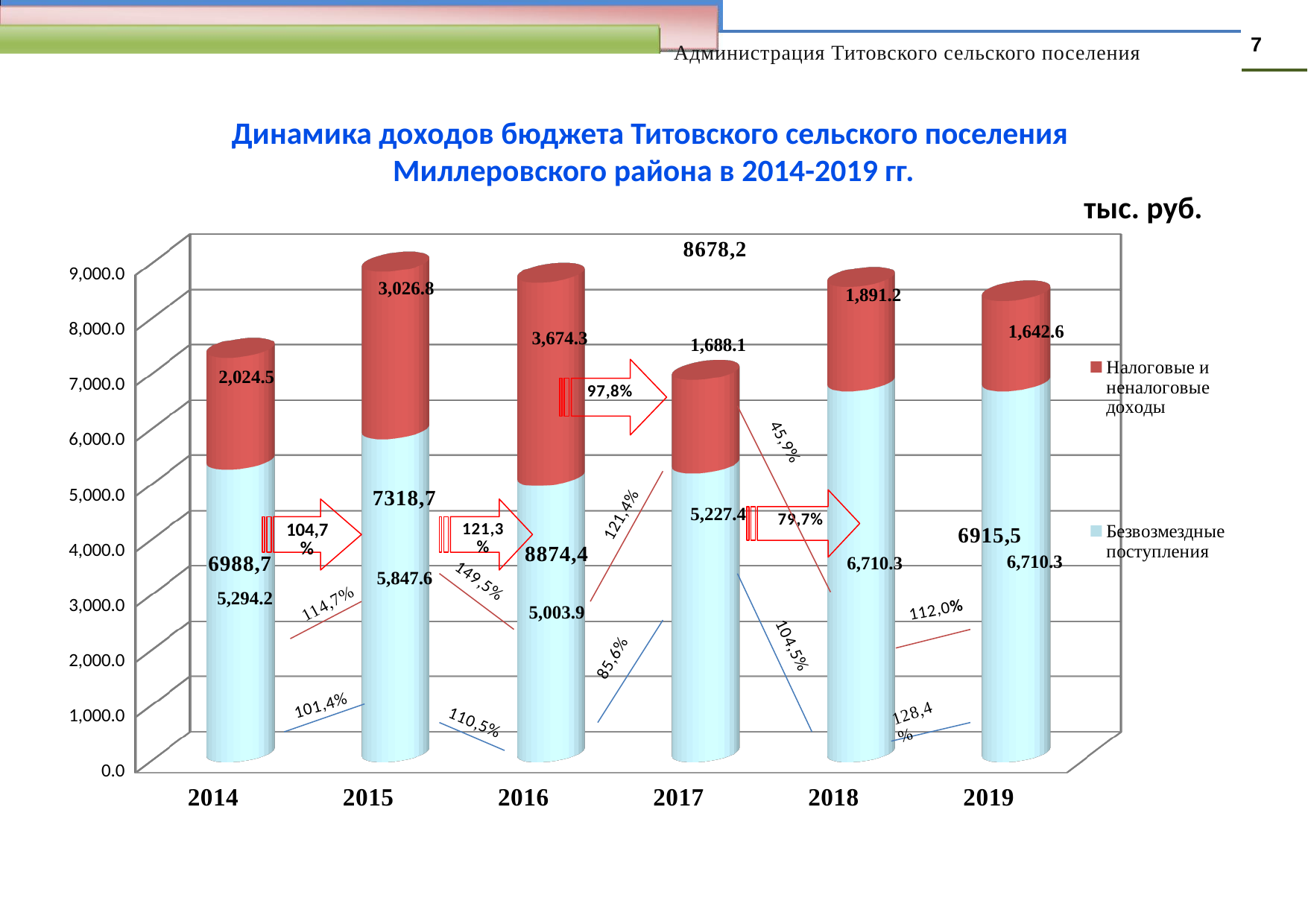
How many series does the legend list? 2 What is the value of Налоговые и неналоговые доходы for 2019? 1,642.6 In which year is Безвозмездные поступления the lowest? 2016 In which year is Налоговые и неналоговые доходы the highest? 2016 Which year has the larger value of Безвозмездные поступления, 2015 or 2017? 2015 What is the value of Налоговые и неналоговые доходы for 2014? 2,024.5 Is the total height of the 2015 bar greater or less than 8,000.0? greater What is the value of Безвозмездные поступления for 2018? 6,710.3 What kind of chart is shown on the slide? Stacked bar chart What is the value of Налоговые и неналоговые доходы for 2016? 3,674.3 How many years are shown on the x axis? 6 What is the difference between Налоговые и неналоговые доходы in 2015 and in 2014? 1,002.3